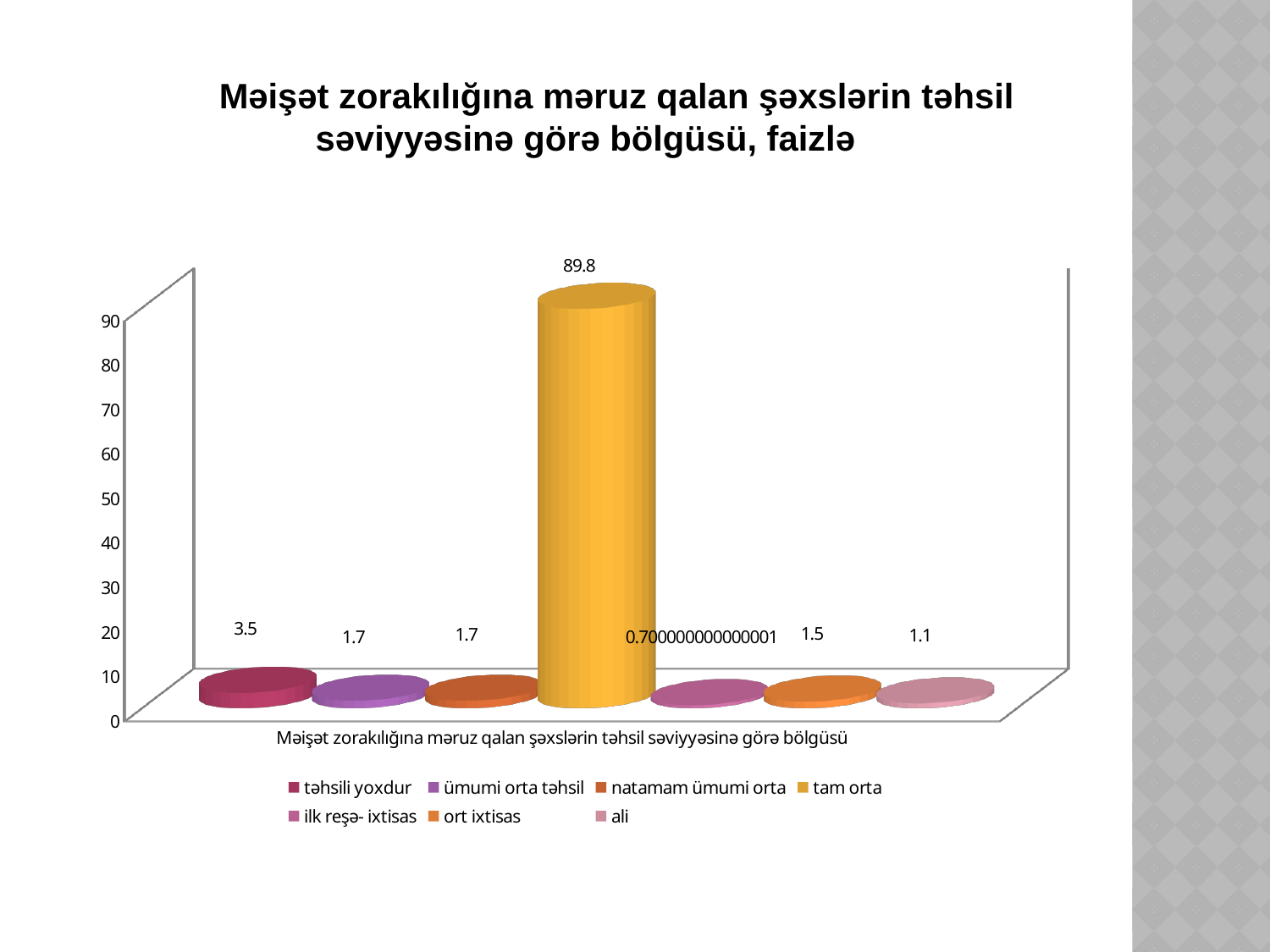
How many series does the legend list? 7 What is the title of the chart? Məişət zorakılığına məruz qalan şəxslərin təhsil səviyyəsinə görə bölgüsü, faizlə Is the value for tam orta greater or less than 80? greater What is the value for ali? 1.1 What is the difference between the values for tam orta and təhsili yoxdur? 86.3 Which education level has the highest value? tam orta What is the value for tam orta? 89.8 Which is larger, the value for təhsili yoxdur or the value for ort ixtisas? təhsili yoxdur What is the value for ort ixtisas? 1.5 What is the value for təhsili yoxdur? 3.5 Which education level has the lowest value? ilk reşə- ixtisas What kind of chart is shown on the slide? bar chart